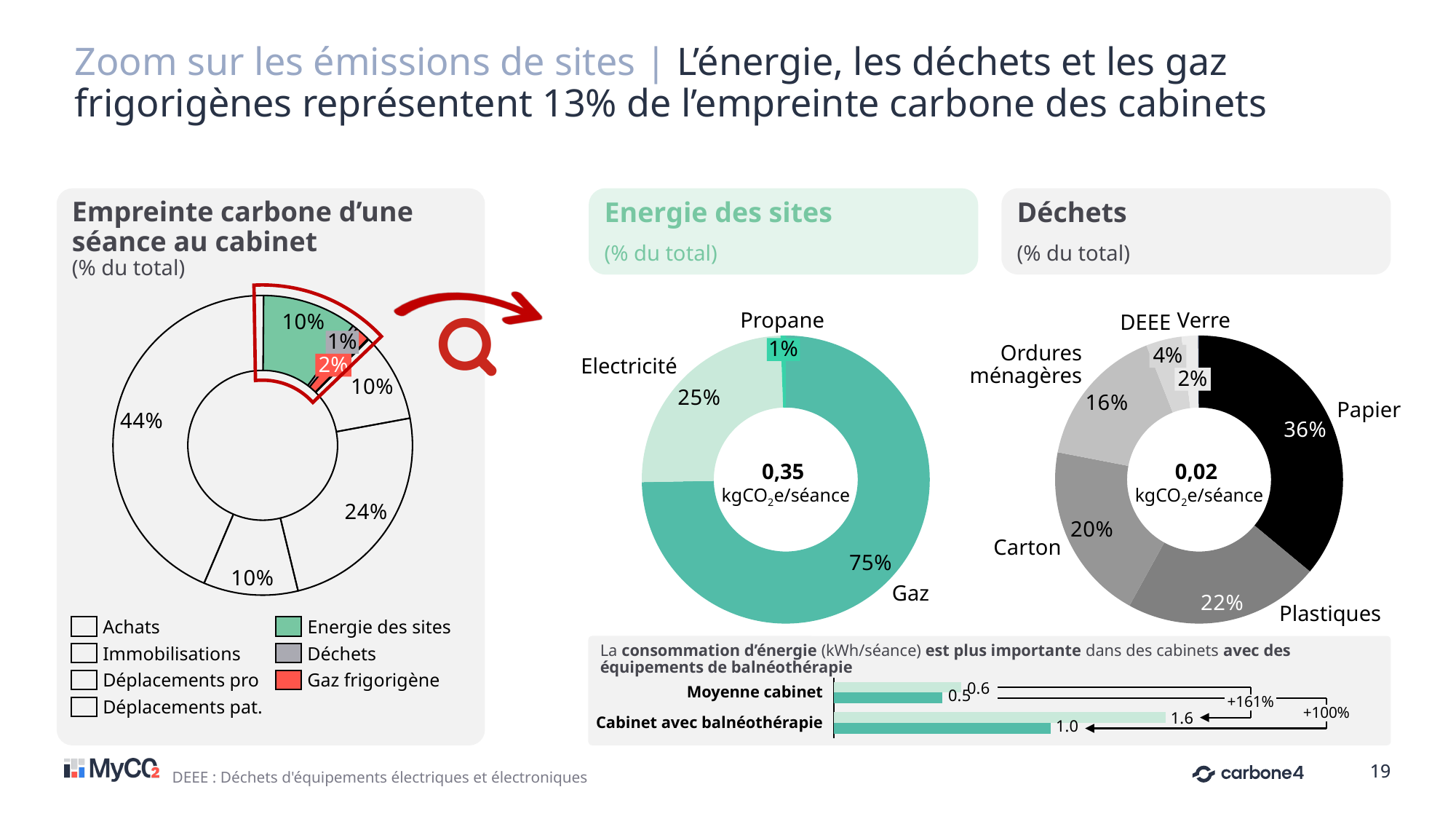
In the 'Energie des sites' donut chart, what share does Gaz represent? 75% In the 'Energie des sites' donut chart, which category has the smallest share? Propane In the 'Déchets' donut chart, which category has the smallest share? Verre In the 'Energie des sites' donut chart, what share does Electricité represent? 25% In the 'Déchets' donut chart, what is the difference between the shares of Plastiques and Carton? 2% In the 'Déchets' donut chart, how many categories are shown? 6 In the 'Déchets' donut chart, which category has the largest share? Papier In the 'Energie des sites' donut chart, what value is printed in the centre of the donut? 0,35 kgCO2e/séance In the 'Empreinte carbone d'une séance au cabinet' donut chart, what share does Energie des sites represent? 10% In the 'Déchets' donut chart, what share does Papier represent? 36% In the 'Empreinte carbone d'une séance au cabinet' donut chart, which is larger: Déchets or Gaz frigorigène? Gaz frigorigène In the bar chart at the bottom of the slide, what is the value of the darker green bar for 'Cabinet avec balnéothérapie'? 1.0